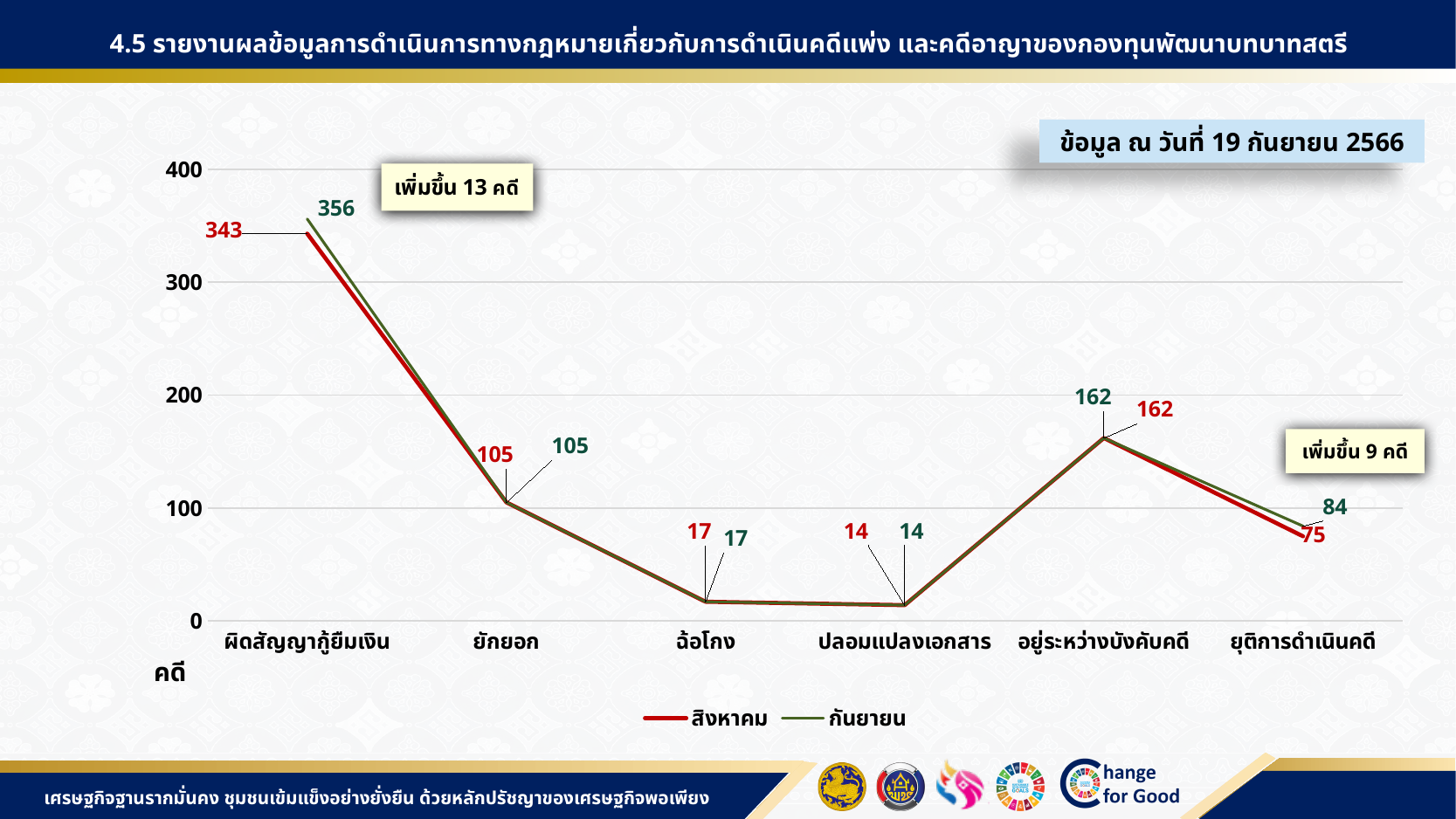
What is the difference between the กันยายน and สิงหาคม values for ผิดสัญญากู้ยืมเงิน? 13 Which category has the highest value in the กันยายน series? ผิดสัญญากู้ยืมเงิน Which series is drawn in red? สิงหาคม What is the value for ผิดสัญญากู้ยืมเงิน in the สิงหาคม series? 343 What type of chart is shown on the slide? line chart How many categories are shown on the x axis? 6 What is the value for ผิดสัญญากู้ยืมเงิน in the กันยายน series? 356 Which category has the lowest value in the สิงหาคม series? ปลอมแปลงเอกสาร What is the value for ยุติการดำเนินคดี in the กันยายน series? 84 How many series does the legend list? 2 Which is larger for ยุติการดำเนินคดี: the สิงหาคม value or the กันยายน value? กันยายน What is the value for ปลอมแปลงเอกสาร in the สิงหาคม series? 14